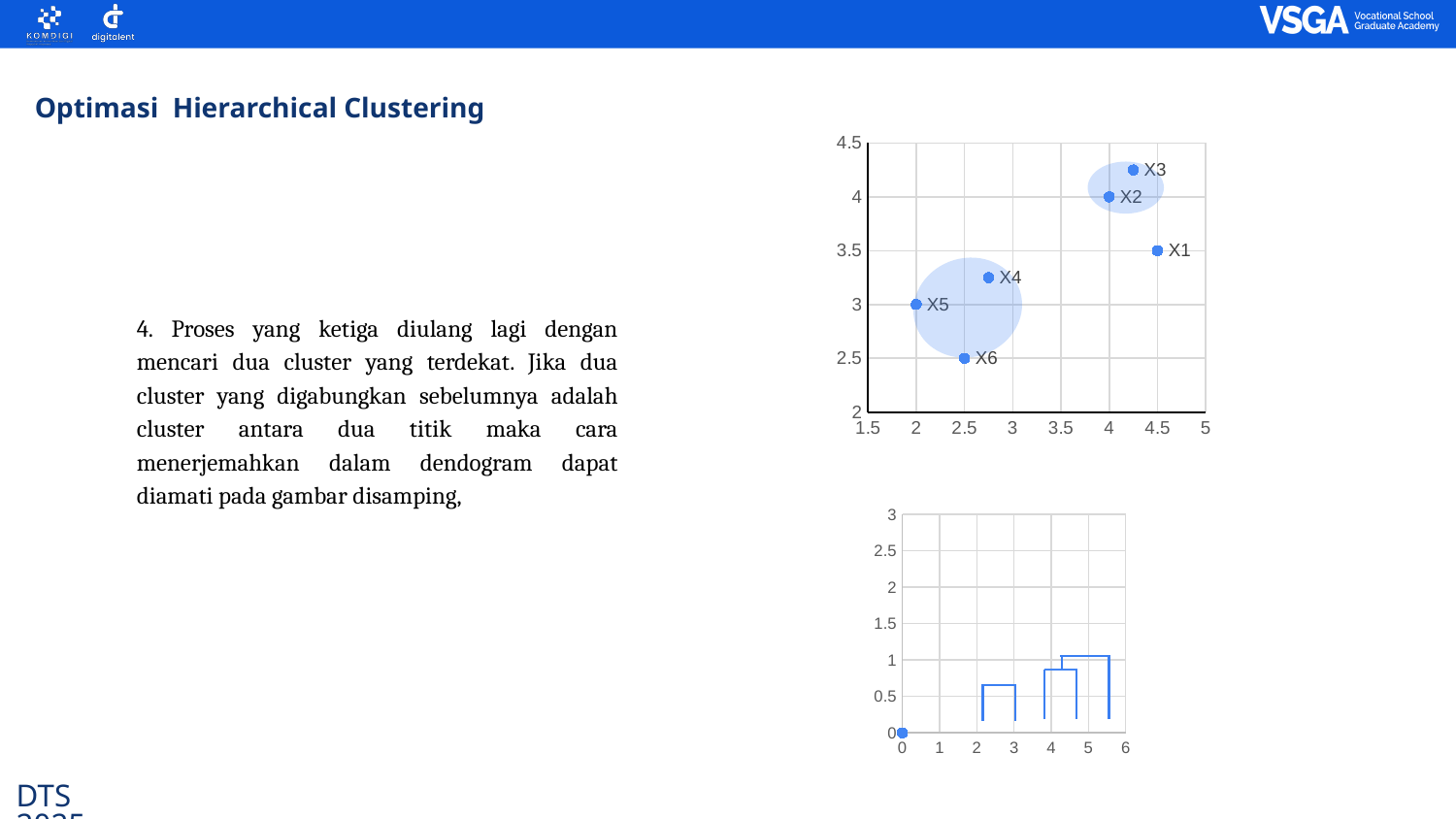
In the top scatter chart, is the y value of X4 greater or less than 3? greater In the top scatter chart, which point has the lowest vertical (y) value? X6 In the top scatter chart, how many points are enclosed by the larger shaded circle on the left? 3 In the top scatter chart, which point is furthest to the left (lowest x value)? X5 In the top scatter chart, how many labelled data points are plotted? 6 In the top scatter chart, what is the y value of point X5? 3 In the top scatter chart, what is the x value of point X2? 4 In the top scatter chart, which point has the highest vertical (y) value? X3 What kind of chart is the top chart on the right of the slide? scatter chart In the top scatter chart, which point is furthest to the right (highest x value)? X1 In the top scatter chart, which point has a higher y value, X1 or X2? X2 In the top scatter chart, what is the y value of point X6? 2.5